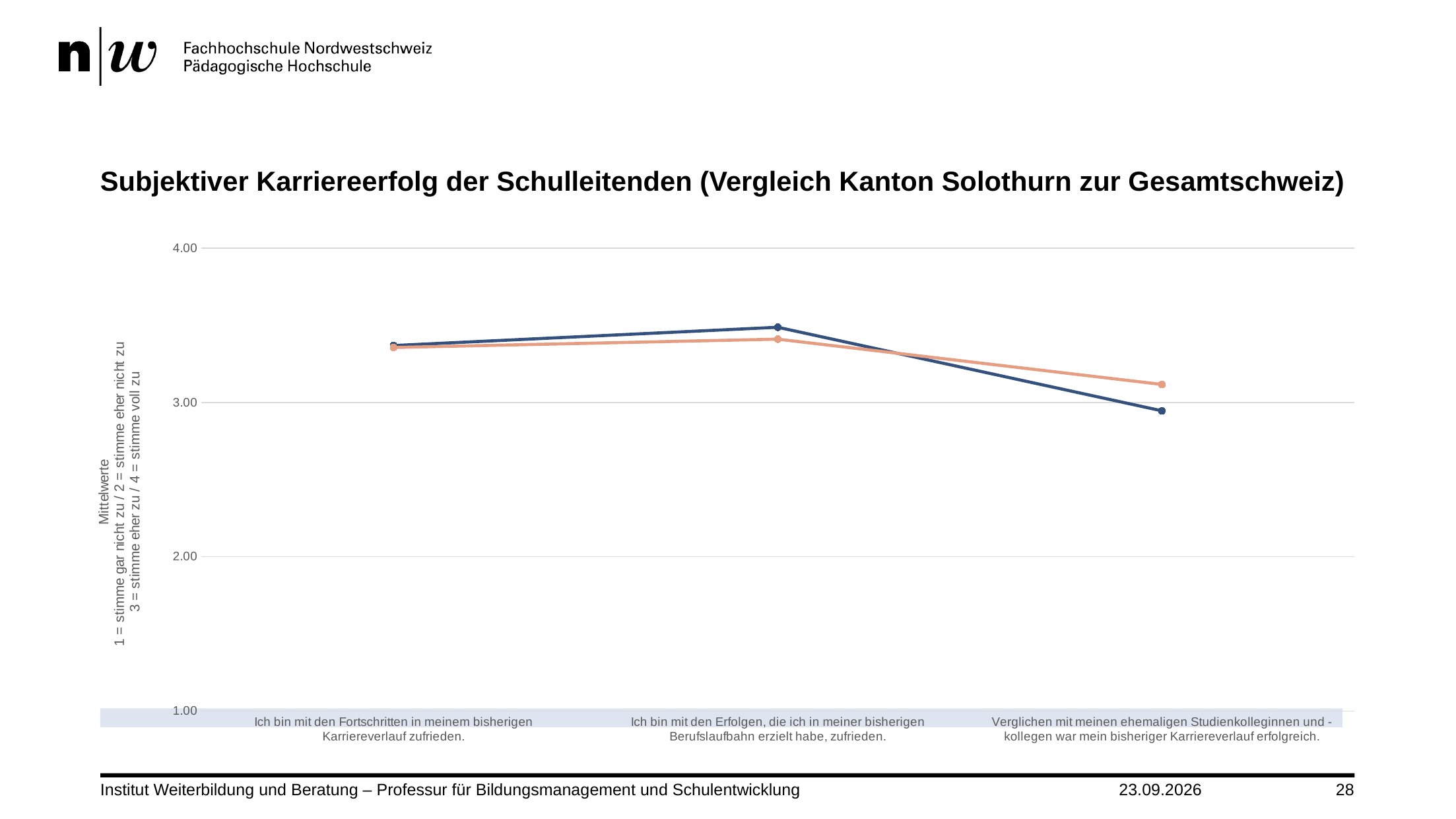
For which statement does the orange line have its lowest value? Verglichen mit meinen ehemaligen Studienkolleginnen und -kollegen war mein bisheriger Karriereverlauf erfolgreich. What is the title of the chart on the slide? Subjektiver Karriereerfolg der Schulleitenden (Vergleich Kanton Solothurn zur Gesamtschweiz) Does the dark blue line end higher or lower at the last statement than it starts at the first statement? lower What kind of chart is shown on the slide? line chart Is the value of the orange line for 'Verglichen mit meinen ehemaligen Studienkolleginnen und -kollegen war mein bisheriger Karriereverlauf erfolgreich.' greater or less than 3.00? greater Is the value of the dark blue line for 'Ich bin mit den Erfolgen, die ich in meiner bisherigen Berufslaufbahn erzielt habe, zufrieden.' greater or less than 3.00? greater How many categories (statements) are shown on the x axis? 3 For 'Verglichen mit meinen ehemaligen Studienkolleginnen und -kollegen war mein bisheriger Karriereverlauf erfolgreich.', which line has the higher value, the dark blue or the orange one? orange For which statement does the dark blue line reach its highest value? Ich bin mit den Erfolgen, die ich in meiner bisherigen Berufslaufbahn erzielt habe, zufrieden. For which statement does the dark blue line have its lowest value? Verglichen mit meinen ehemaligen Studienkolleginnen und -kollegen war mein bisheriger Karriereverlauf erfolgreich. Is the value of the dark blue line for 'Verglichen mit meinen ehemaligen Studienkolleginnen und -kollegen war mein bisheriger Karriereverlauf erfolgreich.' greater or less than 3.00? less How many lines are plotted in the chart? 2